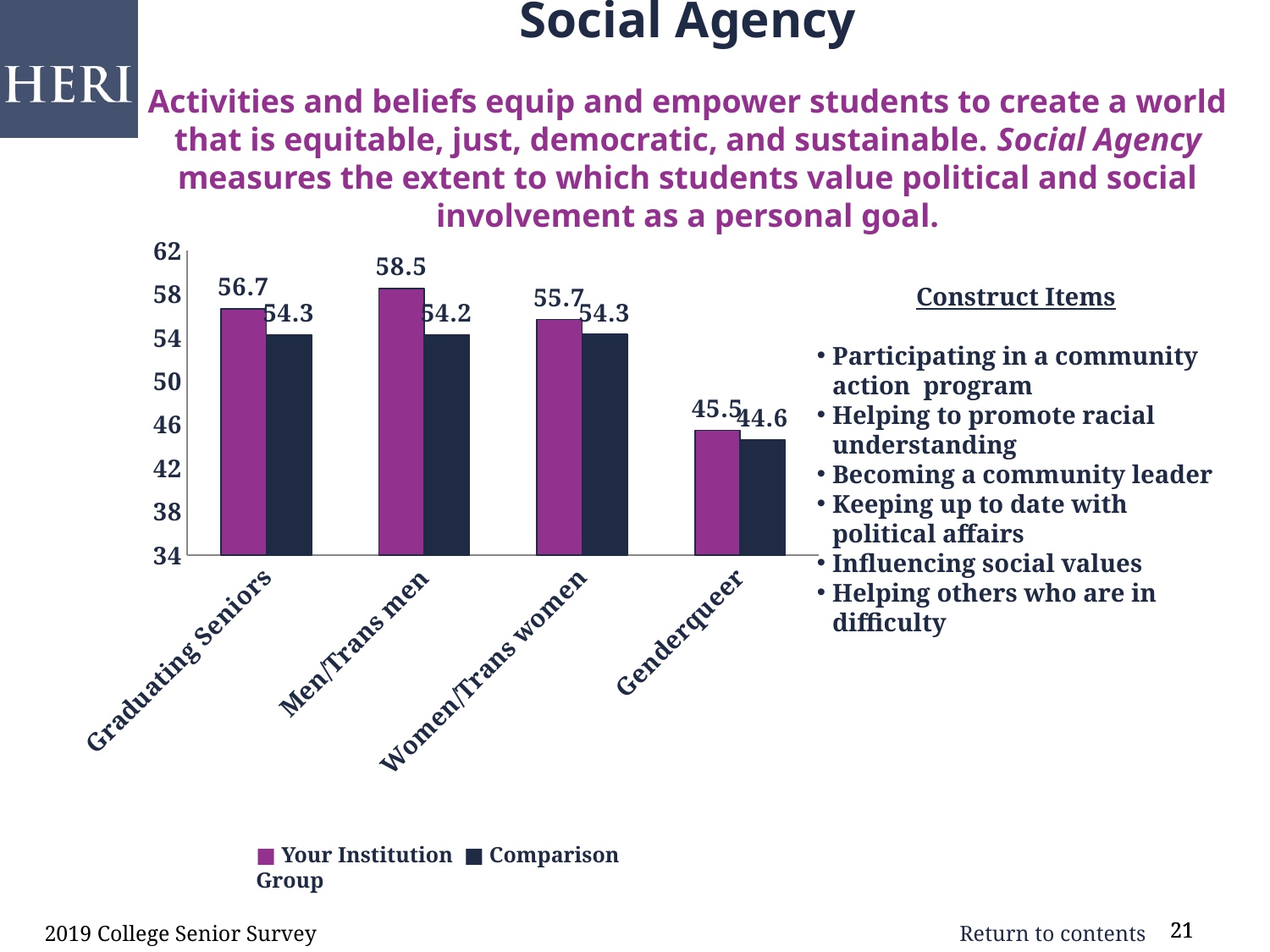
How many series does the legend list? 2 What kind of chart is shown on the slide? bar chart Which is larger for Genderqueer: the Your Institution value or the Comparison Group value? Your Institution Which category has the highest Your Institution value? Men/Trans men How many categories are shown on the x axis? 4 What is the Your Institution value for Graduating Seniors? 56.7 What is the Your Institution value for Men/Trans men? 58.5 What is the Comparison Group value for Genderqueer? 44.6 Is the Your Institution value for Genderqueer greater or less than 50? less What is the difference between the Your Institution and Comparison Group values for Men/Trans men? 4.3 Which category has the lowest Comparison Group value? Genderqueer What is the Comparison Group value for Women/Trans women? 54.3